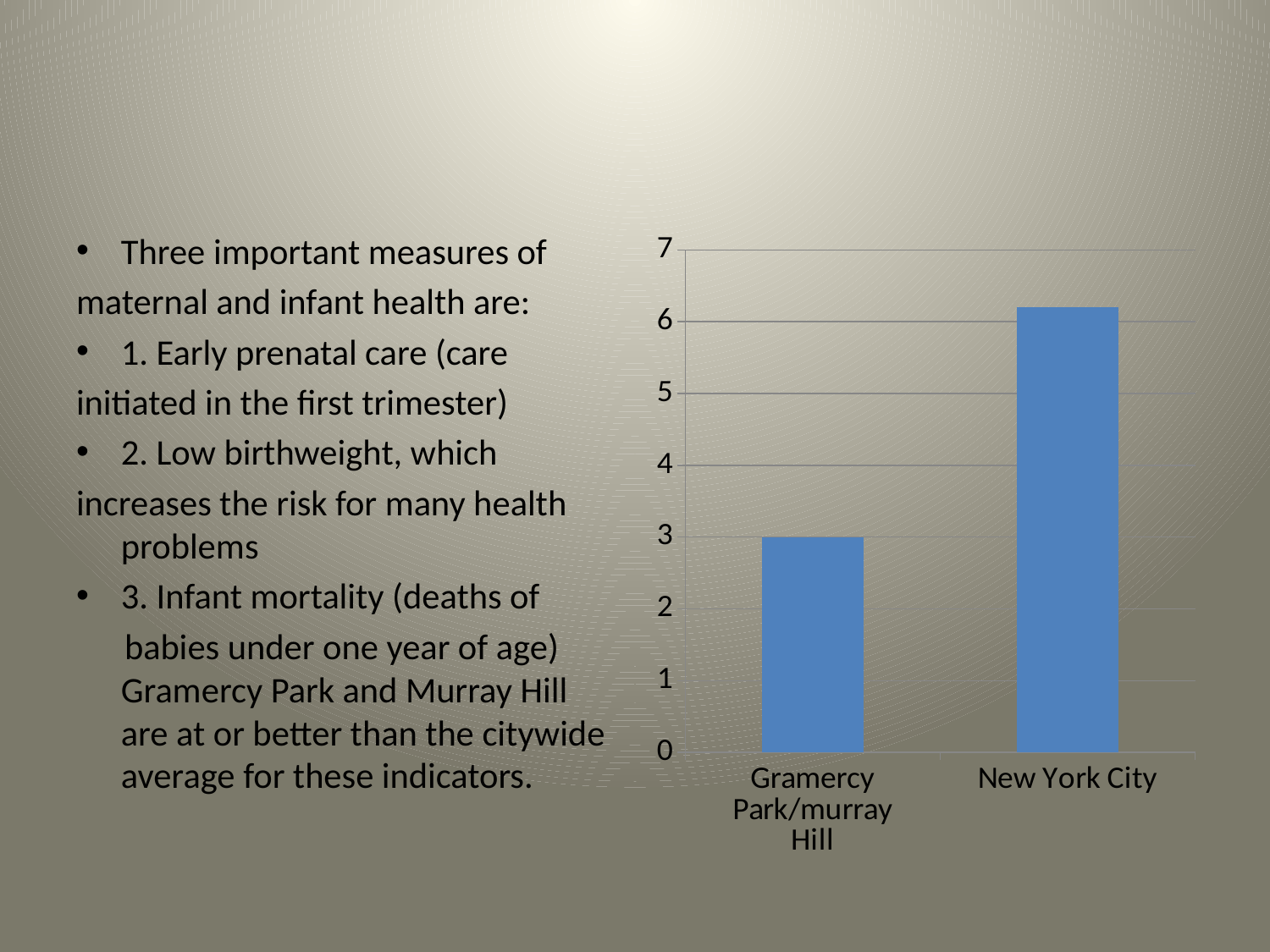
What is the value for Gramercy Park/murray Hill on the chart? 3 Is the value for Gramercy Park/murray Hill greater or less than 2? greater Is the value for Gramercy Park/murray Hill greater or less than 4? less What kind of chart is shown on the slide? bar chart What colour are the bars on the chart? blue How many categories are plotted on the chart? 2 Which category has the lowest value on the chart? Gramercy Park/murray Hill What is the highest value shown on the chart's vertical axis? 7 Which is larger, the value for Gramercy Park/murray Hill or the value for New York City? New York City Is the value for New York City greater or less than 5? greater Which category has the highest value on the chart? New York City